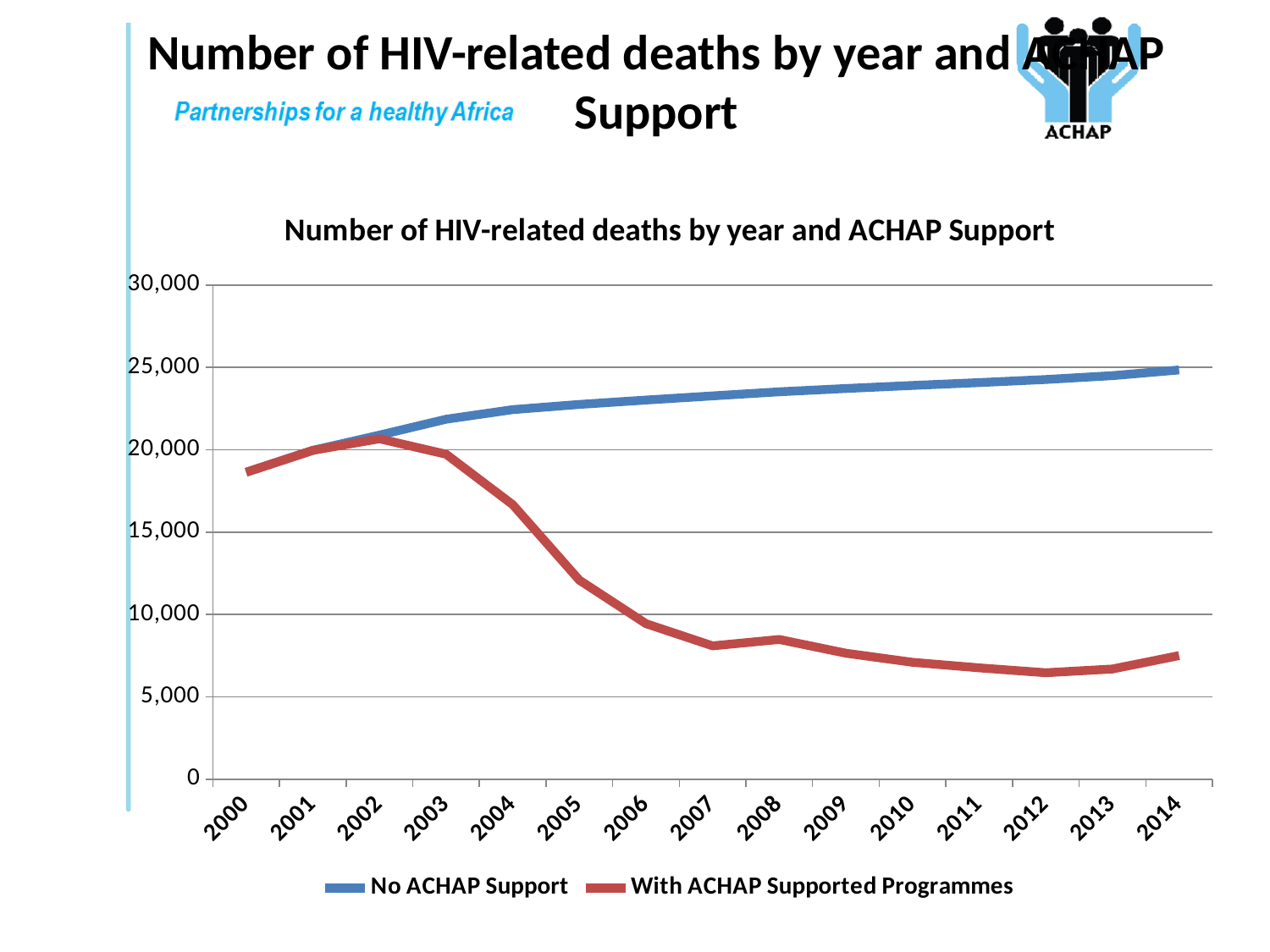
In 2010, which series has the larger value, 'No ACHAP Support' or 'With ACHAP Supported Programmes'? No ACHAP Support What type of chart is shown on the slide? line chart Which series is drawn in red? With ACHAP Supported Programmes Is the value for 'No ACHAP Support' in 2014 greater or less than 20,000? greater Is the value for 'With ACHAP Supported Programmes' in 2005 greater or less than 15,000? less Does the 'No ACHAP Support' series rise or fall from 2000 to 2014? rise In which year does the 'With ACHAP Supported Programmes' series reach its lowest value? 2012 Does the 'With ACHAP Supported Programmes' series rise or fall from 2003 to 2012? fall How many series does the legend list? 2 Is the value for 'With ACHAP Supported Programmes' in 2014 greater or less than 10,000? less What is the title of the chart? Number of HIV-related deaths by year and ACHAP Support How many years are shown on the x axis? 15